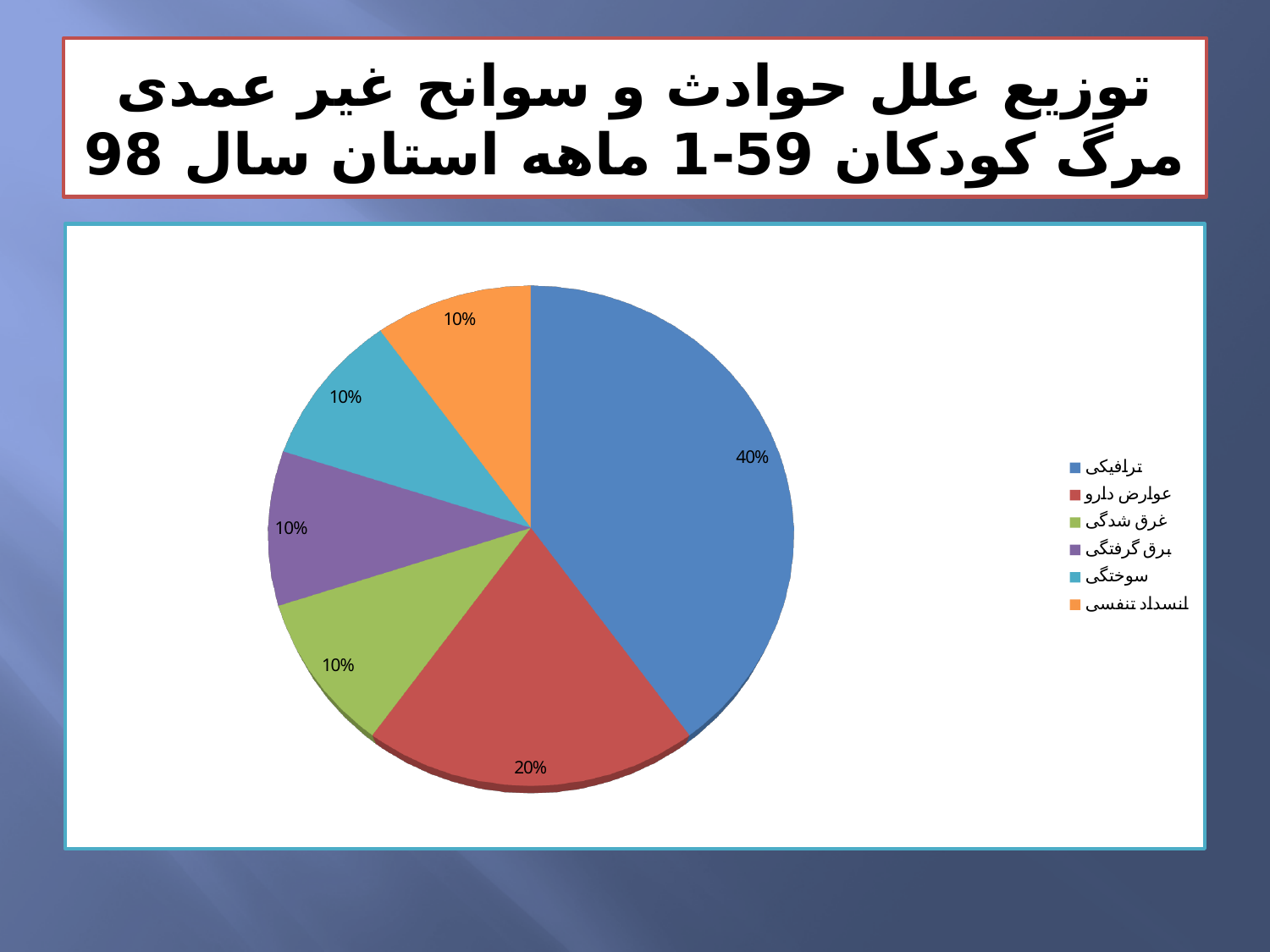
What share of the pie does غرق شدگی (drowning) account for? 10% What share of the pie does عوارض دارو (drug complications) account for? 20% How many categories does the legend list? 6 What kind of chart is shown on the slide? pie chart What colour is the slice for ترافیکی? blue What share of the pie does انسداد تنفسی (respiratory obstruction) account for? 10% What share of the pie does ترافیکی (traffic) account for? 40% Which is larger, the slice for عوارض دارو or the slice for سوختگی? عوارض دارو What is the difference in percentage points between ترافیکی and عوارض دارو? 20 Which category has the largest slice of the pie? ترافیکی What colour is the slice for انسداد تنفسی? orange How many categories have a share of 10%? 4